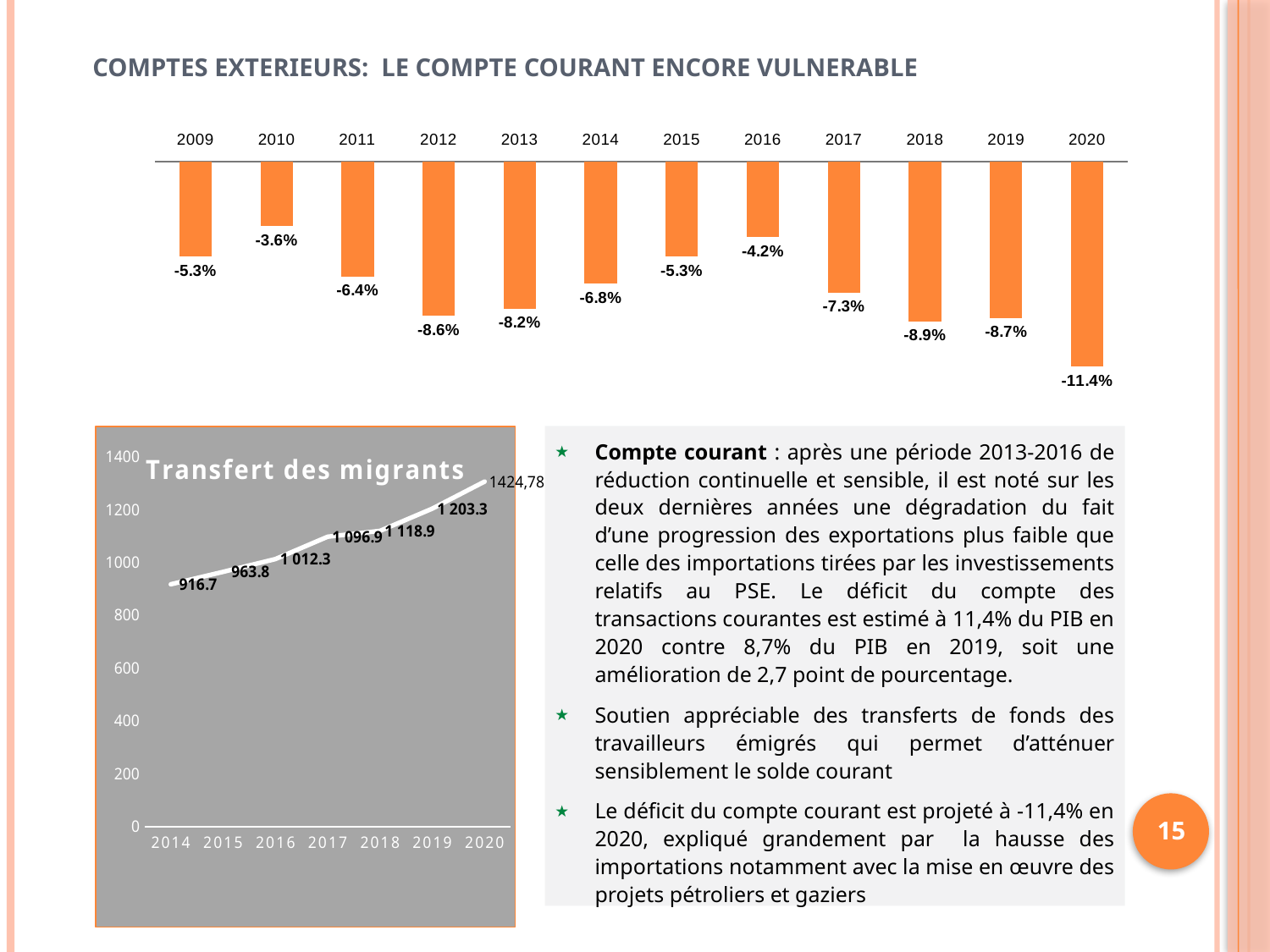
In the top bar chart, what is the value for 2020? -11.4% In the top bar chart, which year has the highest (least negative) value? 2010 What kind of chart is the top chart on the slide? Bar chart In the 'Transfert des migrants' chart, what is the value for 2019? 1 203.3 In the top bar chart, what is the value for 2016? -4.2% In the top bar chart, how many years are shown? 12 In the top bar chart, what is the value for 2010? -3.6% In the top bar chart, which year has the lowest (most negative) value? 2020 In the top bar chart, what is the difference between the values for 2019 and 2020? 2.7 percentage points In the 'Transfert des migrants' chart, how many years are plotted? 7 In the 'Transfert des migrants' chart, do the values rise or fall from 2014 to 2020? Rise In the 'Transfert des migrants' chart, what is the value for 2014? 916.7